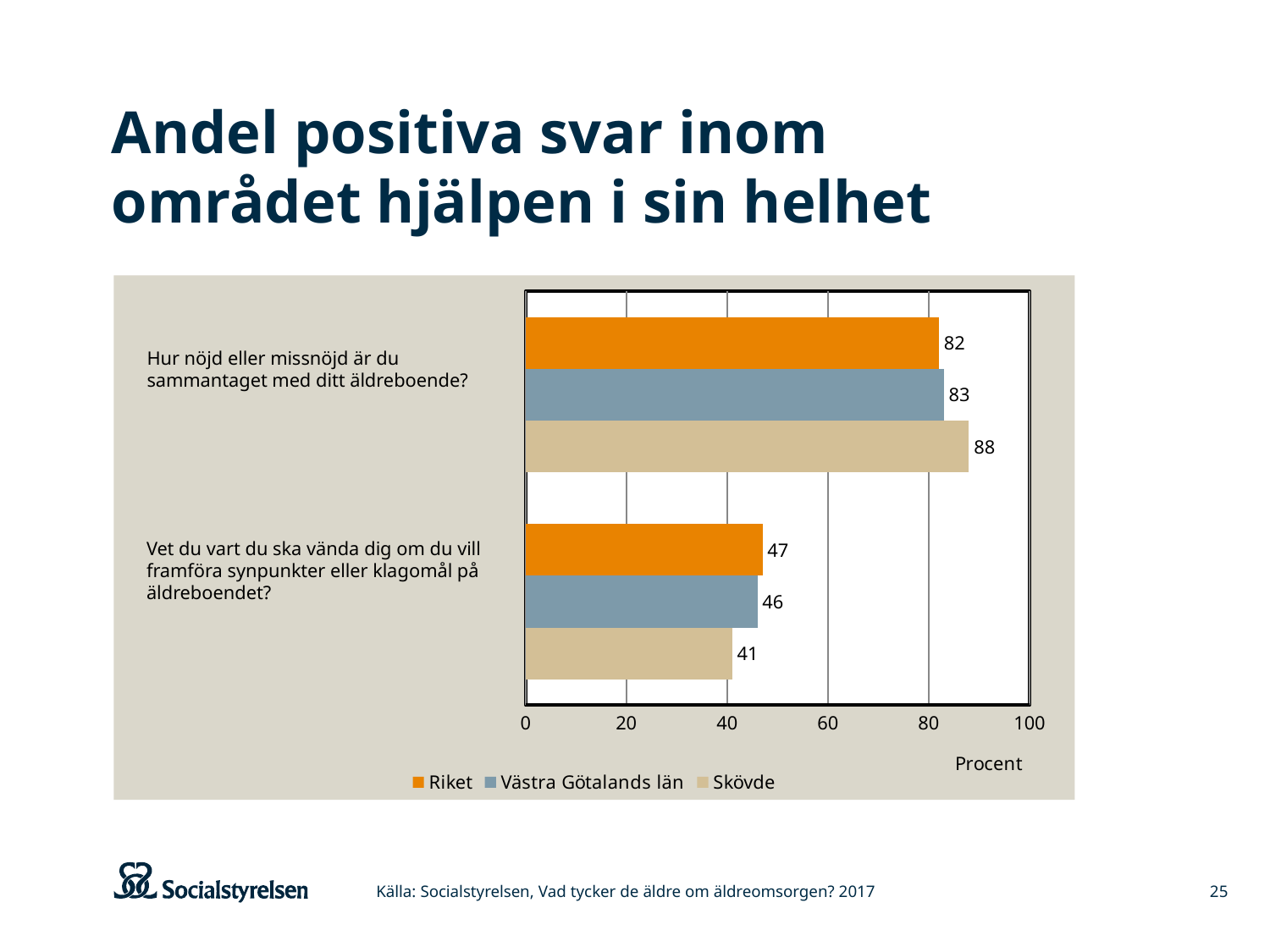
Is the value for Skövde on the question "Vet du vart du ska vända dig om du vill framföra synpunkter eller klagomål på äldreboendet?" greater or less than 60? less What is the label on the horizontal axis of the chart? Procent What is the difference between Skövde and Riket on the question "Hur nöjd eller missnöjd är du sammantaget med ditt äldreboende?"? 6 What is the value for Västra Götalands län on the question "Hur nöjd eller missnöjd är du sammantaget med ditt äldreboende?"? 83 How many questions (categories) are shown in the chart? 2 What kind of chart is shown on the slide? bar chart Which series has the lowest value on the question "Vet du vart du ska vända dig om du vill framföra synpunkter eller klagomål på äldreboendet?"? Skövde How many series does the legend list? 3 What is the value for Skövde on the question "Hur nöjd eller missnöjd är du sammantaget med ditt äldreboende?"? 88 Which is larger on the question "Vet du vart du ska vända dig om du vill framföra synpunkter eller klagomål på äldreboendet?": Riket or Skövde? Riket Which series has the highest value on the question "Hur nöjd eller missnöjd är du sammantaget med ditt äldreboende?"? Skövde What is the value for Riket on the question "Vet du vart du ska vända dig om du vill framföra synpunkter eller klagomål på äldreboendet?"? 47